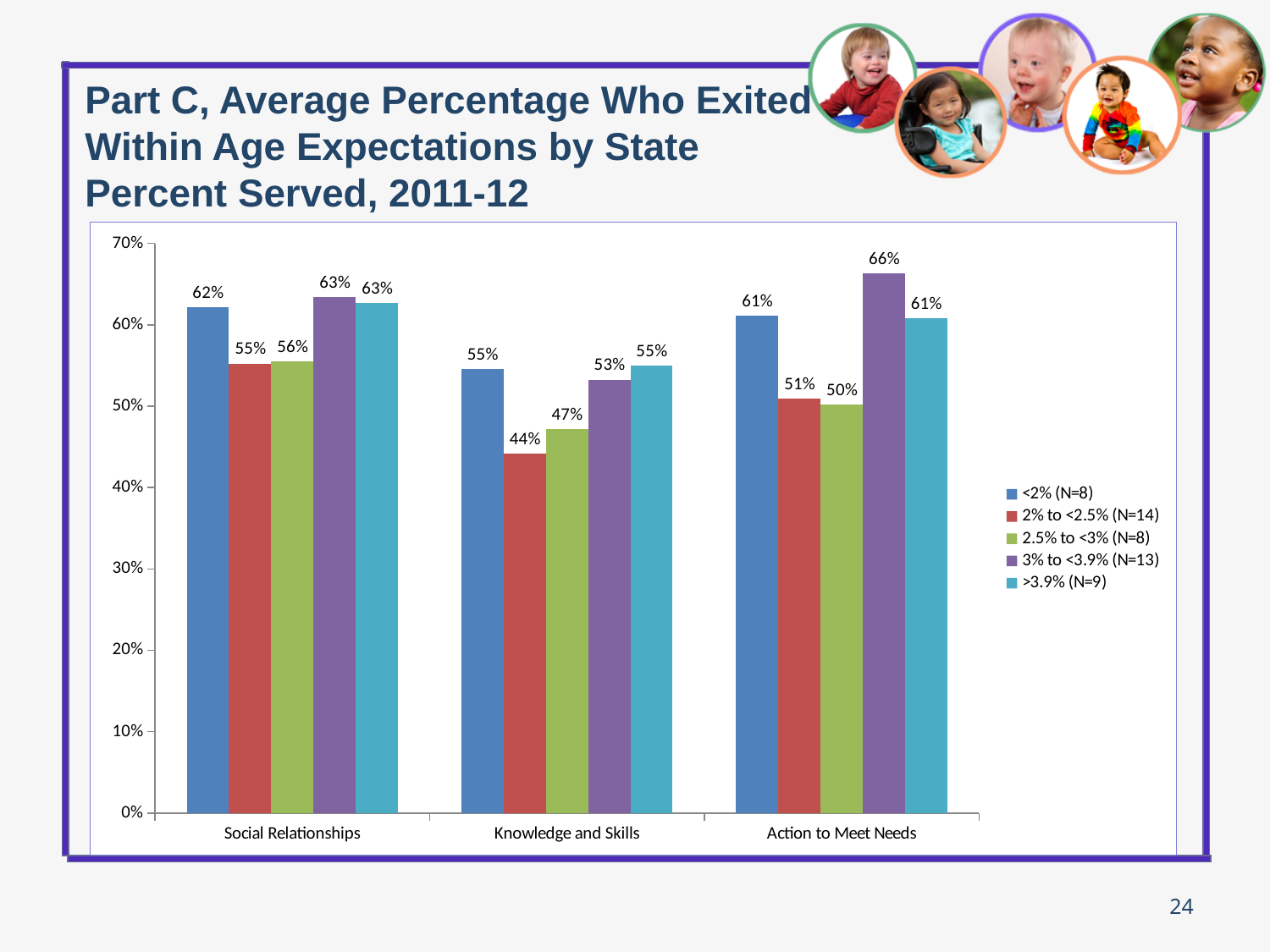
What is the value for the 2.5% to <3% (N=8) series in the Action to Meet Needs category? 50% How many categories are shown on the x axis? 3 Which legend entry has N=9? >3.9% (N=9) What is the value for the 3% to <3.9% (N=13) series in the Action to Meet Needs category? 66% What is the difference between the 3% to <3.9% (N=13) value and the 2.5% to <3% (N=8) value in the Action to Meet Needs category? 16% What is the value for the 2% to <2.5% (N=14) series in the Knowledge and Skills category? 44% What is the value for the <2% (N=8) series in the Social Relationships category? 62% Which series has the lowest value in the Knowledge and Skills category? 2% to <2.5% (N=14) How many series does the legend list? 5 Which series has the highest value in the Action to Meet Needs category? 3% to <3.9% (N=13) What kind of chart is shown on the slide? Bar chart In the Knowledge and Skills category, which is larger: the <2% (N=8) value or the 2.5% to <3% (N=8) value? <2% (N=8)